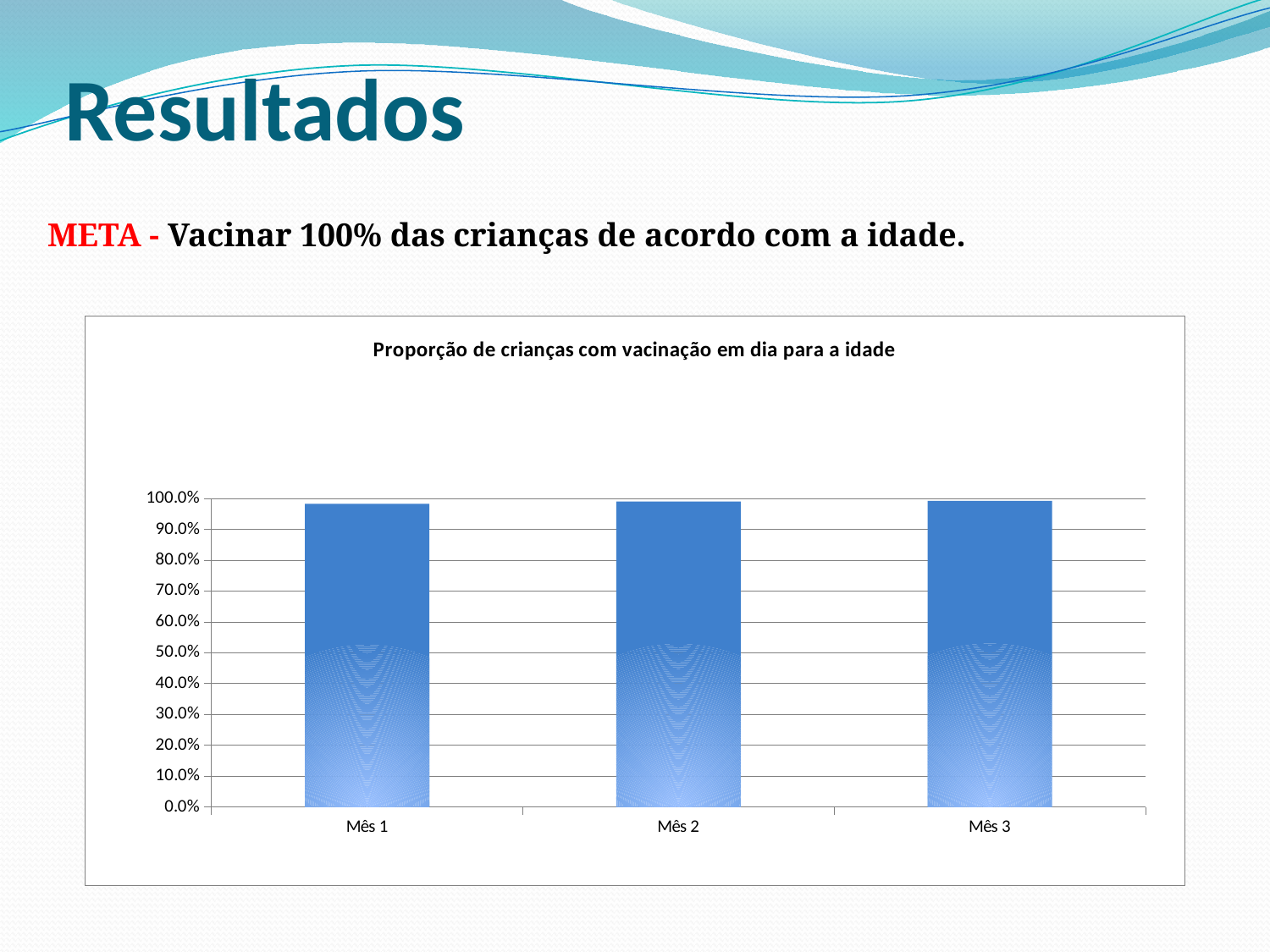
What is the title of the chart? Proporção de crianças com vacinação em dia para a idade Is the value for Mês 2 greater or less than 50.0%? greater What kind of chart is shown on the slide? bar chart What is the label of the first category on the x axis? Mês 1 How many categories are plotted on the x axis of the chart? 3 Is the value for Mês 1 greater or less than 90.0%? greater Is the value for Mês 1 greater or less than 100.0%? less What is the highest tick value shown on the y axis of the chart? 100.0%